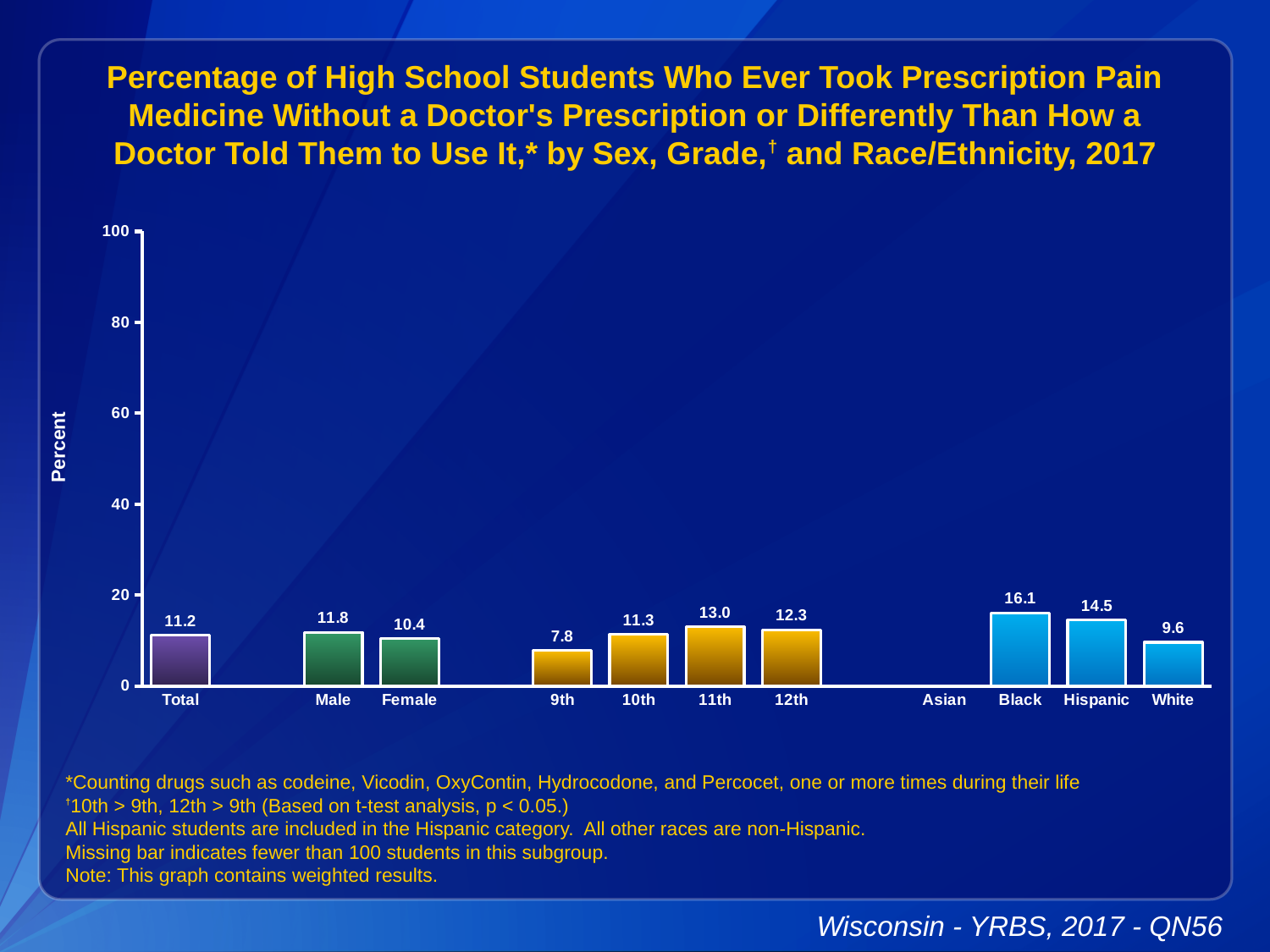
Which category has no bar shown? Asian Which is larger, the value for Hispanic or the value for White? Hispanic What is the value for 9th grade? 7.8 Which category has the lowest value among the bars shown? 9th What is the value for Black students? 16.1 What is the value for Male? 11.8 How many bars are plotted on the chart? 10 What kind of chart is shown? bar chart What is the value for Total? 11.2 Which category has the highest value? Black What is the difference between the Male and Female values? 1.4 Is the value for 11th grade greater or less than 20? less